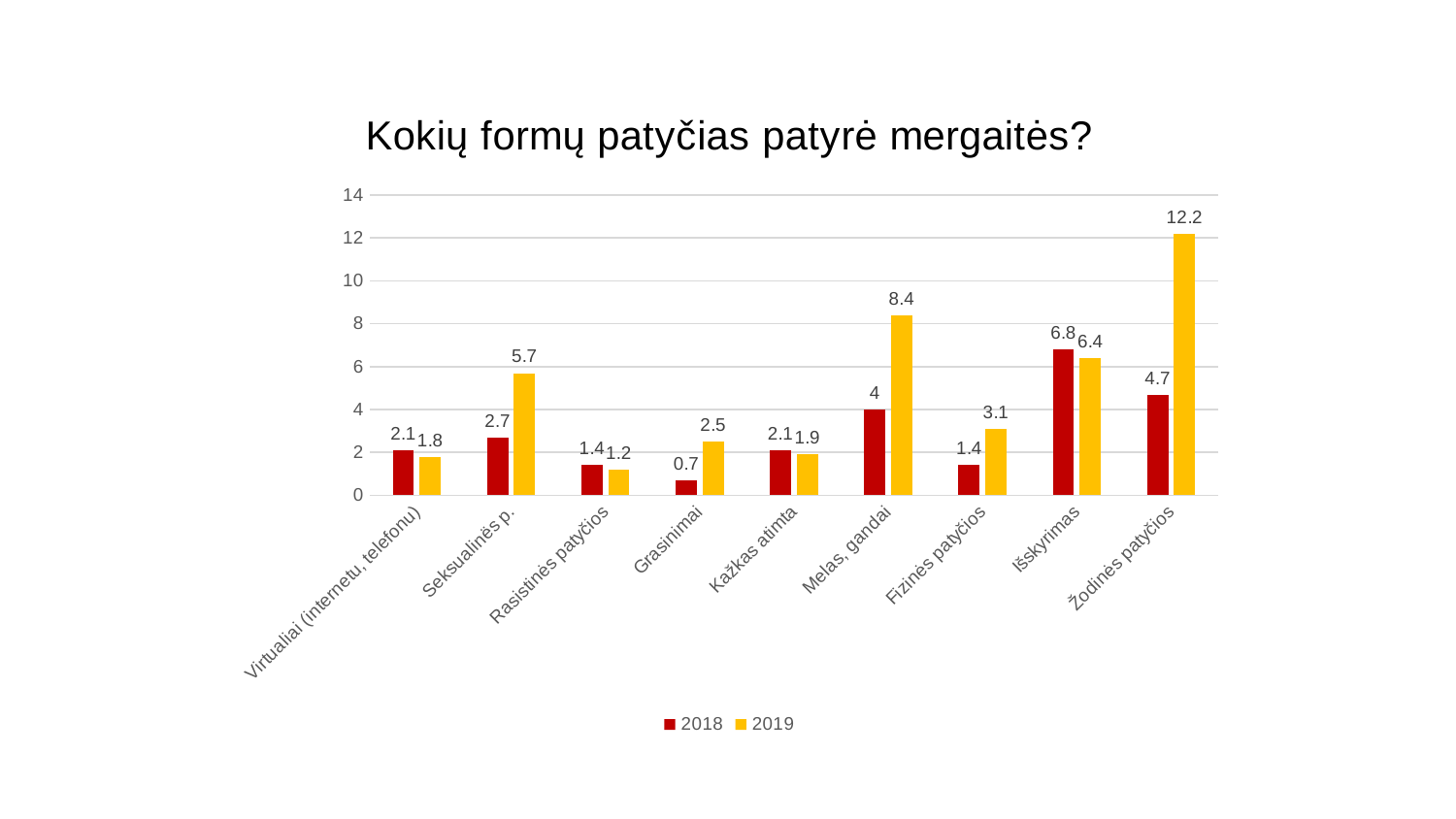
Is the 2019 value for Melas, gandai greater or less than 8? greater What is the title of the chart? Kokių formų patyčias patyrė mergaitės? What is the 2018 value for Grasinimai? 0.7 Which category has the highest 2019 value? Žodinės patyčios Which is larger for Išskyrimas, the 2018 value or the 2019 value? 2018 What kind of chart is shown on the slide? Bar chart What is the 2019 value for Žodinės patyčios? 12.2 Which category has the lowest 2018 value? Grasinimai What is the difference between the 2019 and 2018 values for Seksualinės p.? 3 What is the 2018 value for Melas, gandai? 4 How many series does the legend list? 2 How many categories are shown on the x axis? 9